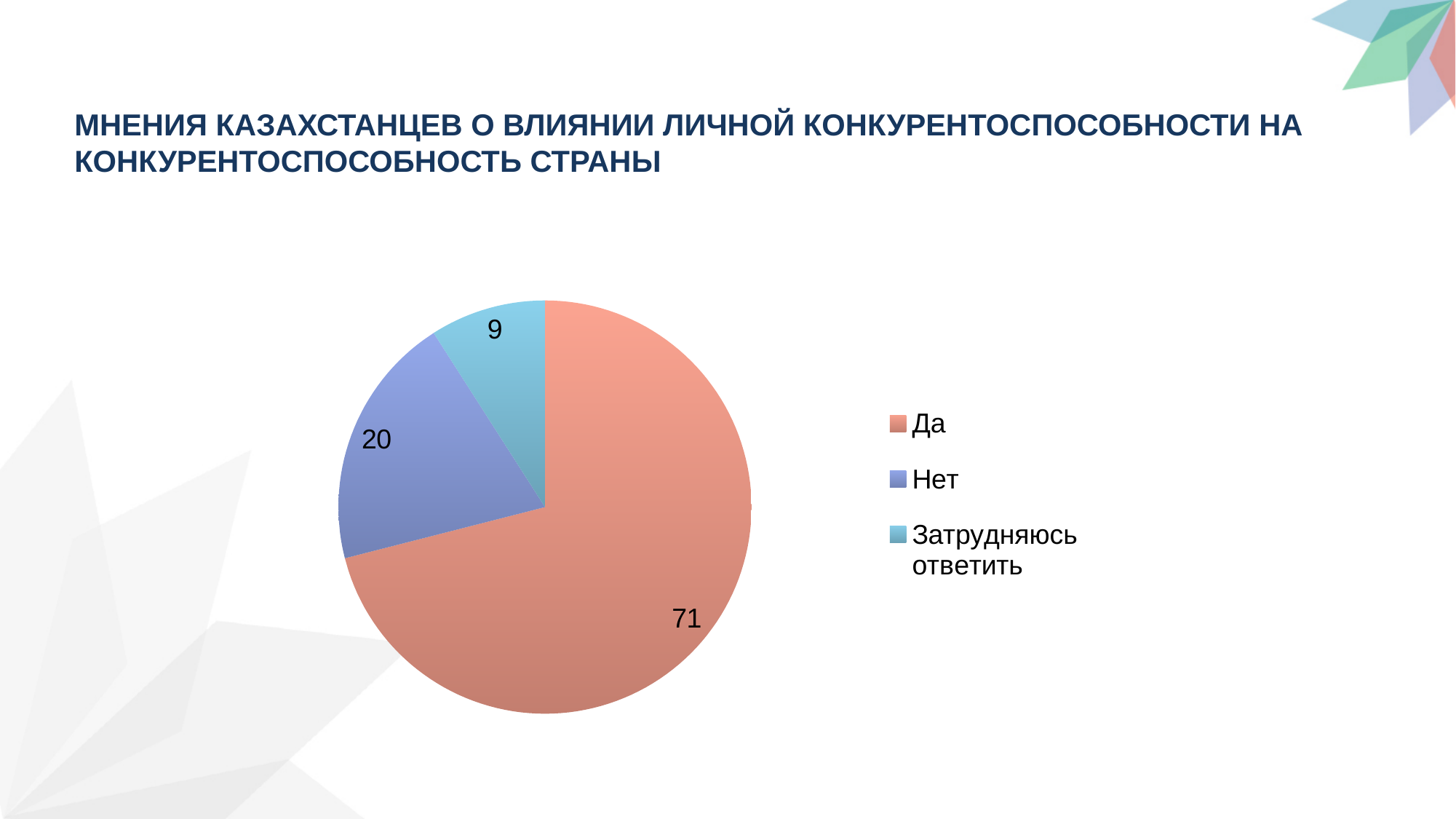
What is the value for the "Да" slice? 71 Which is larger, the value for "Нет" or the value for "Затрудняюсь ответить"? Нет What is the value for the "Нет" slice? 20 How many entries does the legend list? 3 What type of chart is shown on the slide? pie chart What colour is the "Да" slice? red (salmon) Which category has the largest slice? Да What is the difference between the values for "Нет" and "Затрудняюсь ответить"? 11 How many slices does the pie chart have? 3 What is the value for the "Затрудняюсь ответить" slice? 9 Which category has the smallest slice? Затрудняюсь ответить What is the difference between the values for "Да" and "Нет"? 51